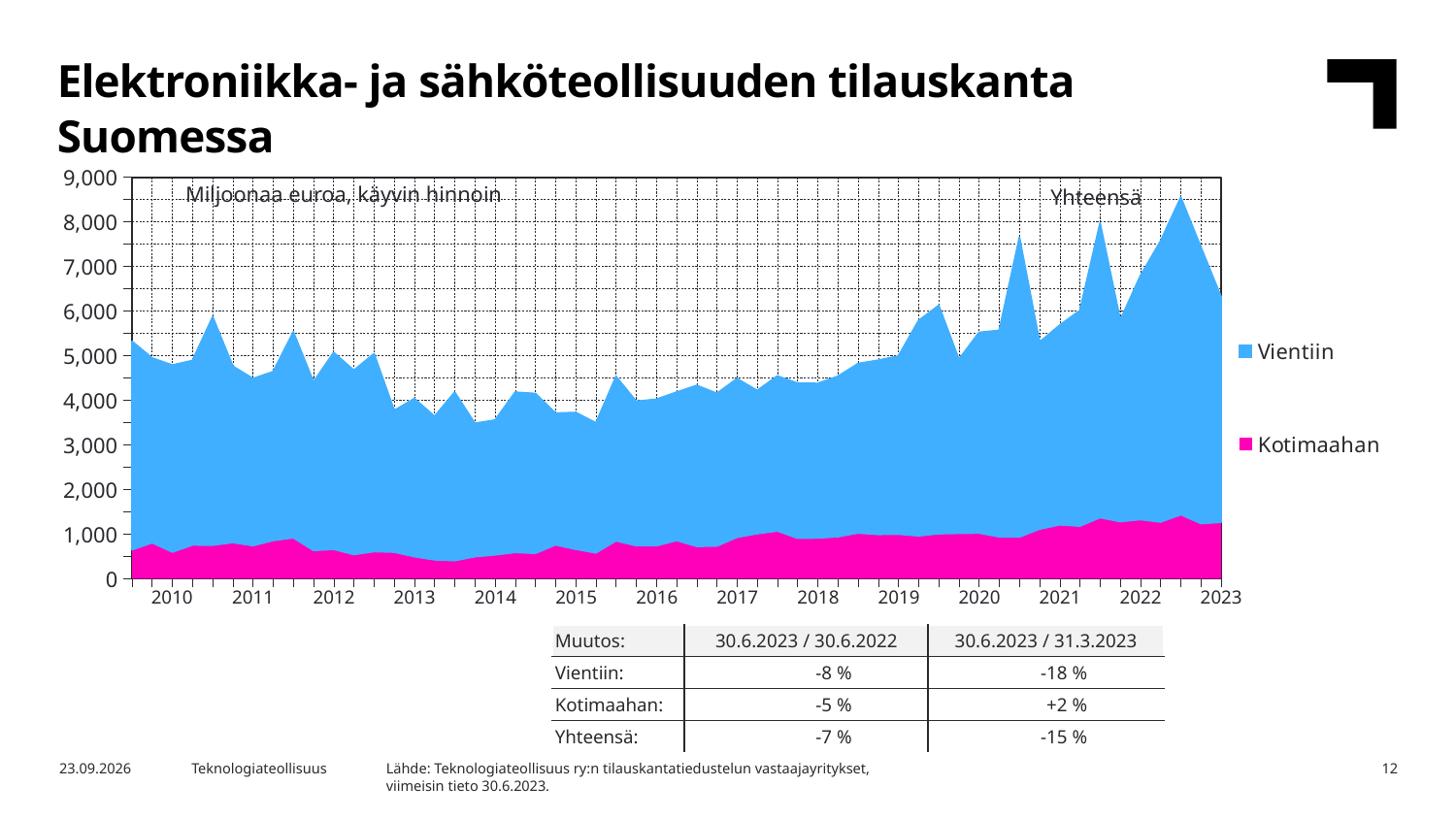
What unit is stated in the chart for the values? Miljoonaa euroa, käyvin hinnoin Does the total order backlog rise or fall overall from 2010 to 2014? fall Which two series are listed in the chart legend? Vientiin and Kotimaahan Which series is larger throughout the chart, Vientiin or Kotimaahan? Vientiin Is the peak total (Yhteensä) reached in 2022 greater or less than 8,000? greater What kind of chart is shown on the slide? Stacked area chart Is the Kotimaahan value at any point greater or less than 2,000? less According to the table below the chart, what is the change in Vientiin for 30.6.2023 / 30.6.2022? -8 % What is the highest value shown on the vertical axis? 9,000 How many series does the legend list? 2 How many year labels are shown on the horizontal axis? 14 Does the Kotimaahan series rise or fall overall from 2010 to 2023? rise